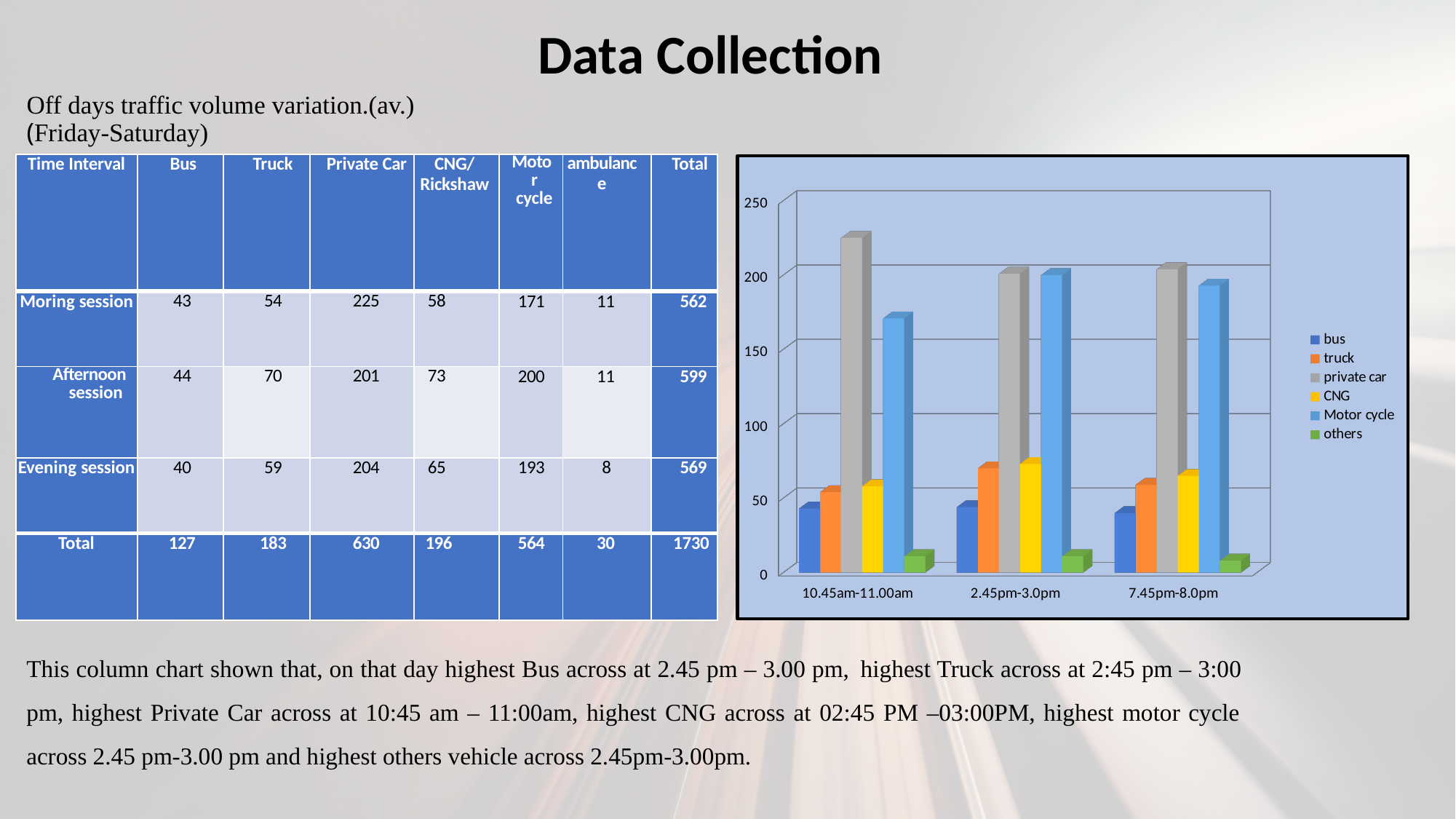
Is the value for others at 7.45pm-8.0pm greater or less than 50? less Which series has the shortest bars in every time-interval group? others Is the value for truck at 2.45pm-3.0pm greater or less than 50? greater How many series does the chart legend list? 6 How many time-interval categories are shown on the chart's x axis? 3 Which colour represents private car in the chart legend? grey Is the value for private car at 10.45am-11.00am greater or less than 200? greater What kind of chart is shown on the slide? bar chart At 10.45am-11.00am, which is larger: private car or Motor cycle? private car Which series has the tallest bar in the 10.45am-11.00am group? private car